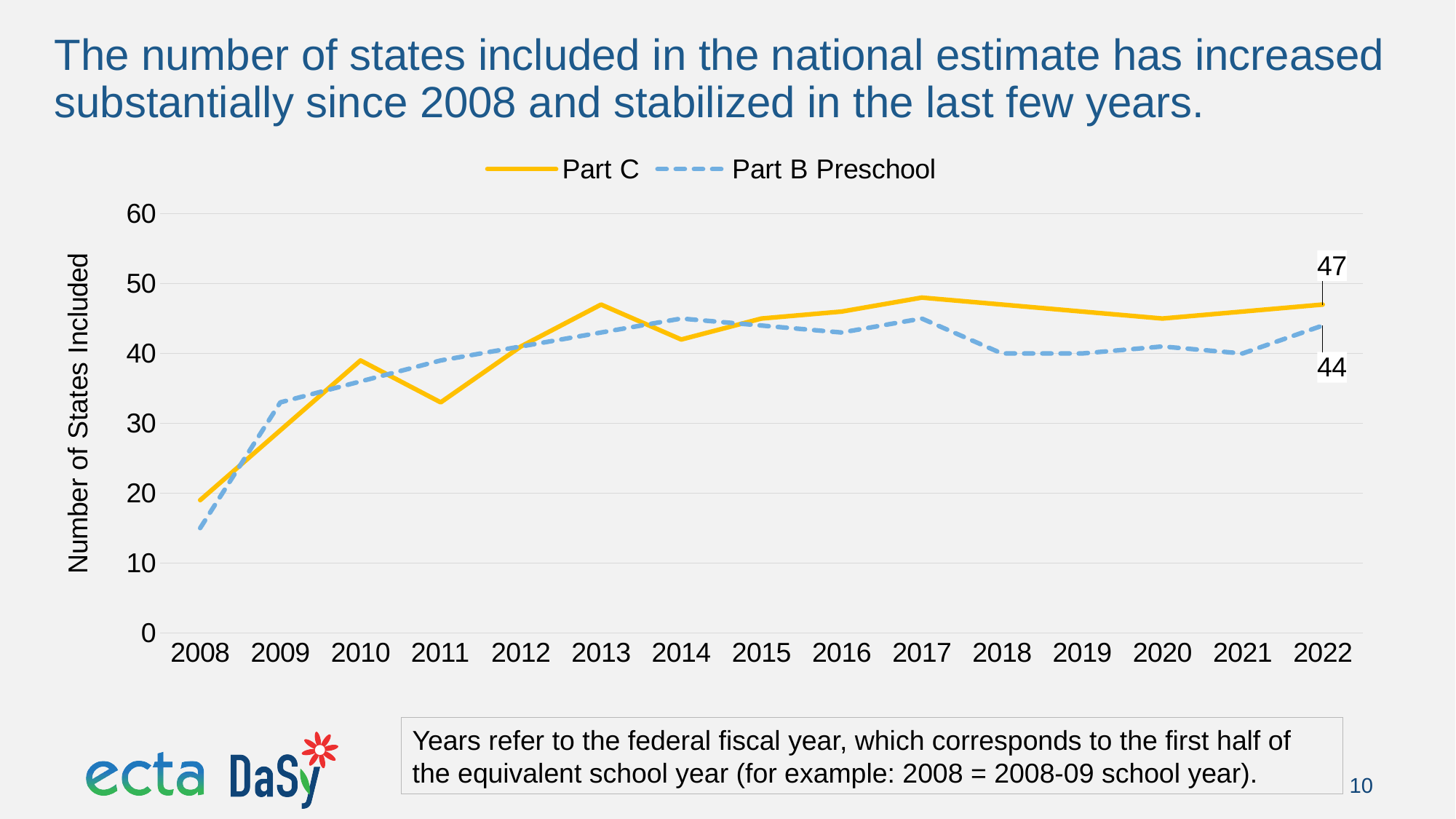
What is the value for Part B Preschool in 2022? 44 Is the value for Part C in 2017 greater or less than 40? greater How many years are shown on the x axis? 15 Is the value for Part C in 2011 greater or less than 30? greater Is the value for Part B Preschool in 2008 greater or less than 20? less In 2022, which series has the larger value, Part C or Part B Preschool? Part C What is the title of the y axis? Number of States Included How many series does the legend list? 2 What is the difference between the Part C and Part B Preschool values in 2022? 3 In which year is the Part C value lowest? 2008 What is the value for Part C in 2022? 47 What kind of chart is shown on the slide? line chart